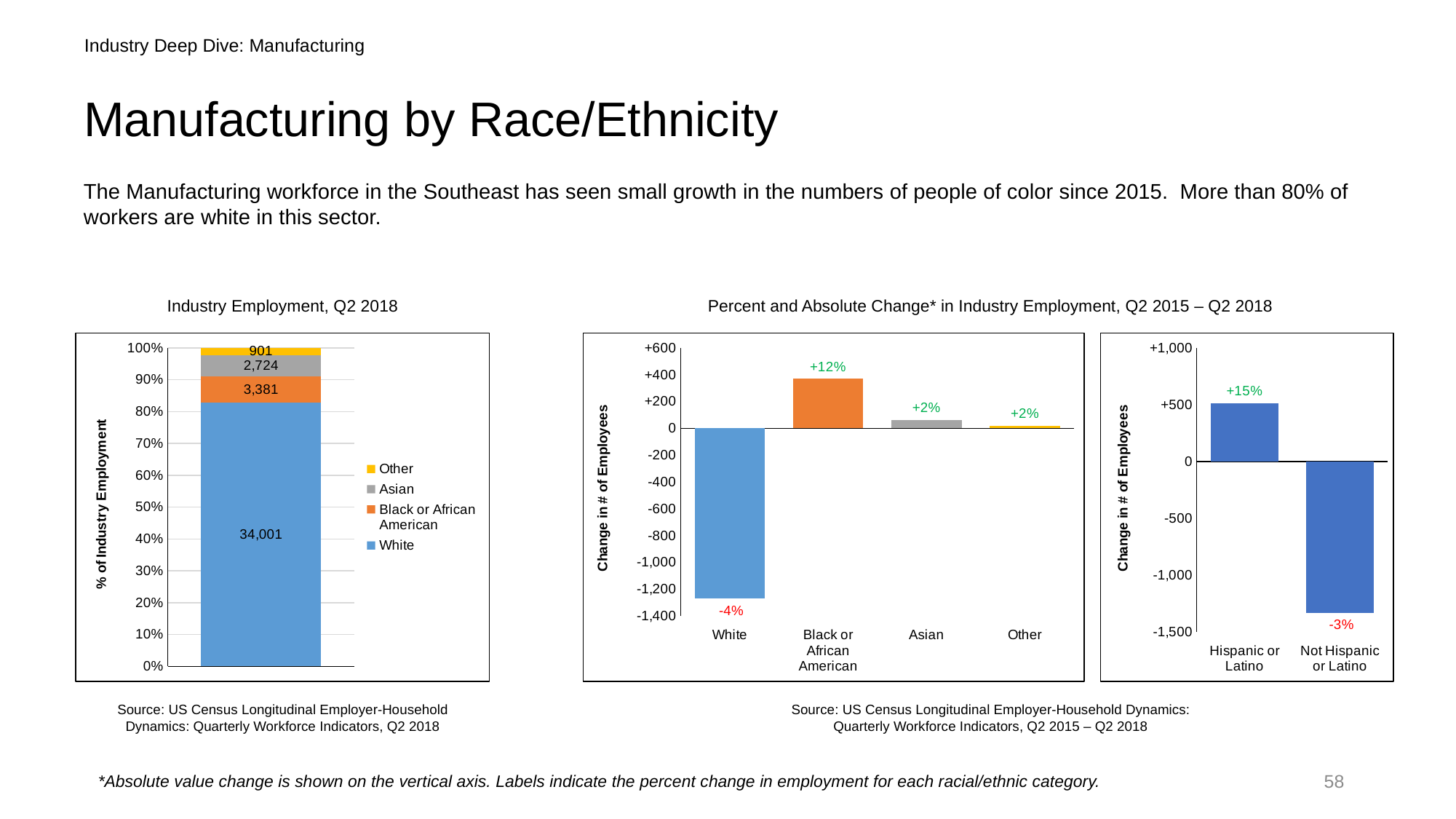
In the middle chart (Percent and Absolute Change in Industry Employment), what percent change label is shown for White? -4% In the rightmost chart (Hispanic or Latino vs Not Hispanic or Latino), is the change in number of employees for Not Hispanic or Latino greater or less than -1,000? less What kind of chart is the 'Industry Employment, Q2 2018' chart? Stacked bar chart In the middle chart (Percent and Absolute Change in Industry Employment), what percent change label is shown for Black or African American? +12% In the 'Industry Employment, Q2 2018' chart, what is the total of all four segments in the stacked bar? 41,007 How many series does the legend of the 'Industry Employment, Q2 2018' chart list? 4 In the 'Industry Employment, Q2 2018' chart, what is the difference between the Black or African American segment and the Asian segment? 657 In the rightmost chart (Hispanic or Latino vs Not Hispanic or Latino), what percent change label is shown for Hispanic or Latino? +15% In the 'Industry Employment, Q2 2018' chart, which group has the smallest segment? Other In the 'Industry Employment, Q2 2018' chart, what value is shown for the Asian segment? 2,724 In the 'Industry Employment, Q2 2018' chart, what value is shown for the White segment? 34,001 In the middle chart (Percent and Absolute Change in Industry Employment), is the change in number of employees for White greater or less than -1,200? less